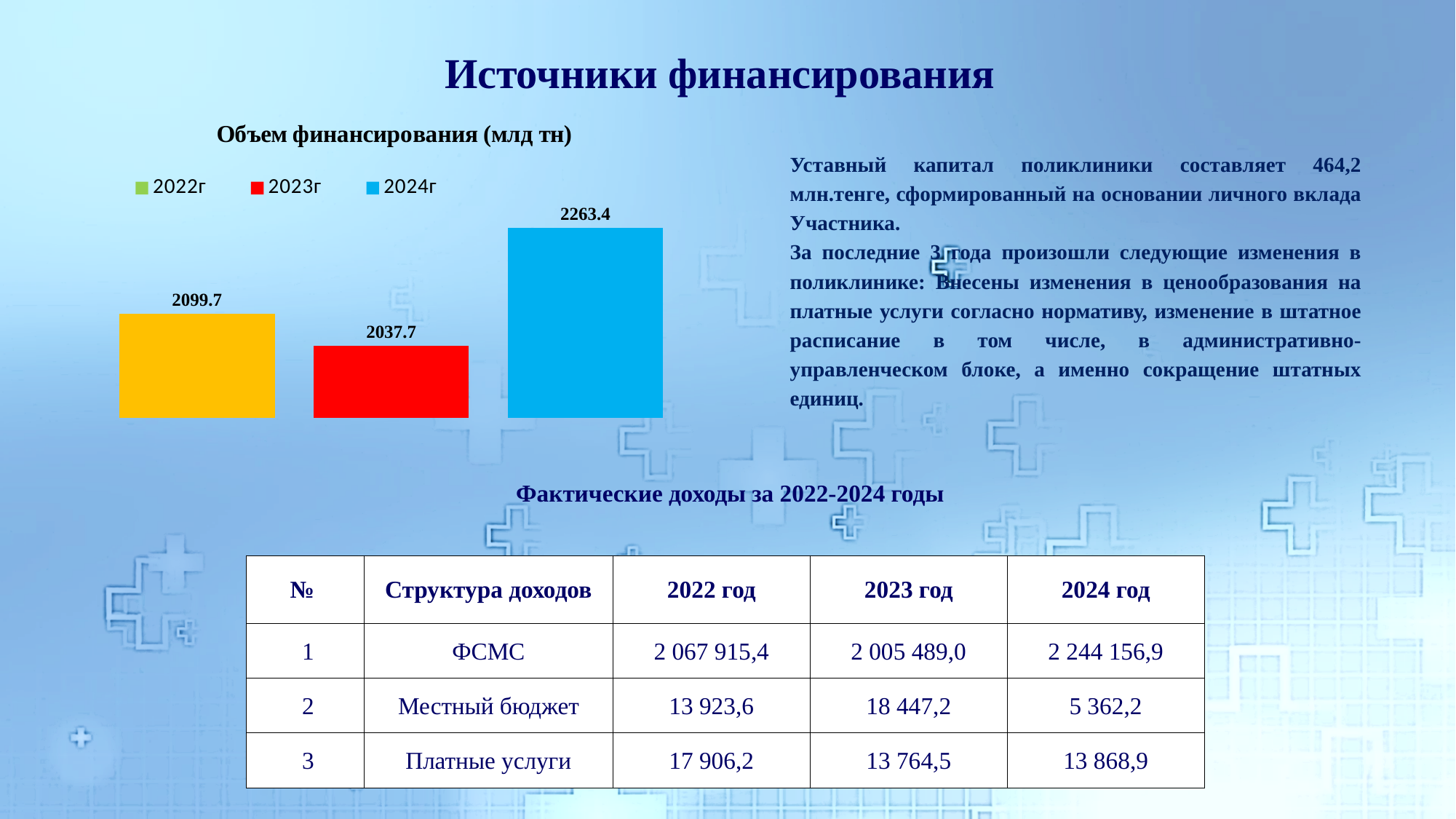
How many bars are plotted in the chart 'Объем финансирования (млд тн)'? 3 What is the title of the chart on the slide? Объем финансирования (млд тн) What is the value for 2022г in the chart 'Объем финансирования (млд тн)'? 2099.7 Which year has the lowest value in the chart 'Объем финансирования (млд тн)'? 2023г How many entries does the legend of the chart 'Объем финансирования (млд тн)' list? 3 What is the difference between the 2024г and 2023г values in the chart 'Объем финансирования (млд тн)'? 225.7 What is the value for 2024г in the chart 'Объем финансирования (млд тн)'? 2263.4 Which year has the highest value in the chart 'Объем финансирования (млд тн)'? 2024г What is the value for 2023г in the chart 'Объем финансирования (млд тн)'? 2037.7 In the chart 'Объем финансирования (млд тн)', which is larger: the value for 2022г or for 2024г? 2024г What type of chart is 'Объем финансирования (млд тн)'? Bar chart What is the difference between the 2022г and 2023г values in the chart 'Объем финансирования (млд тн)'? 62.0